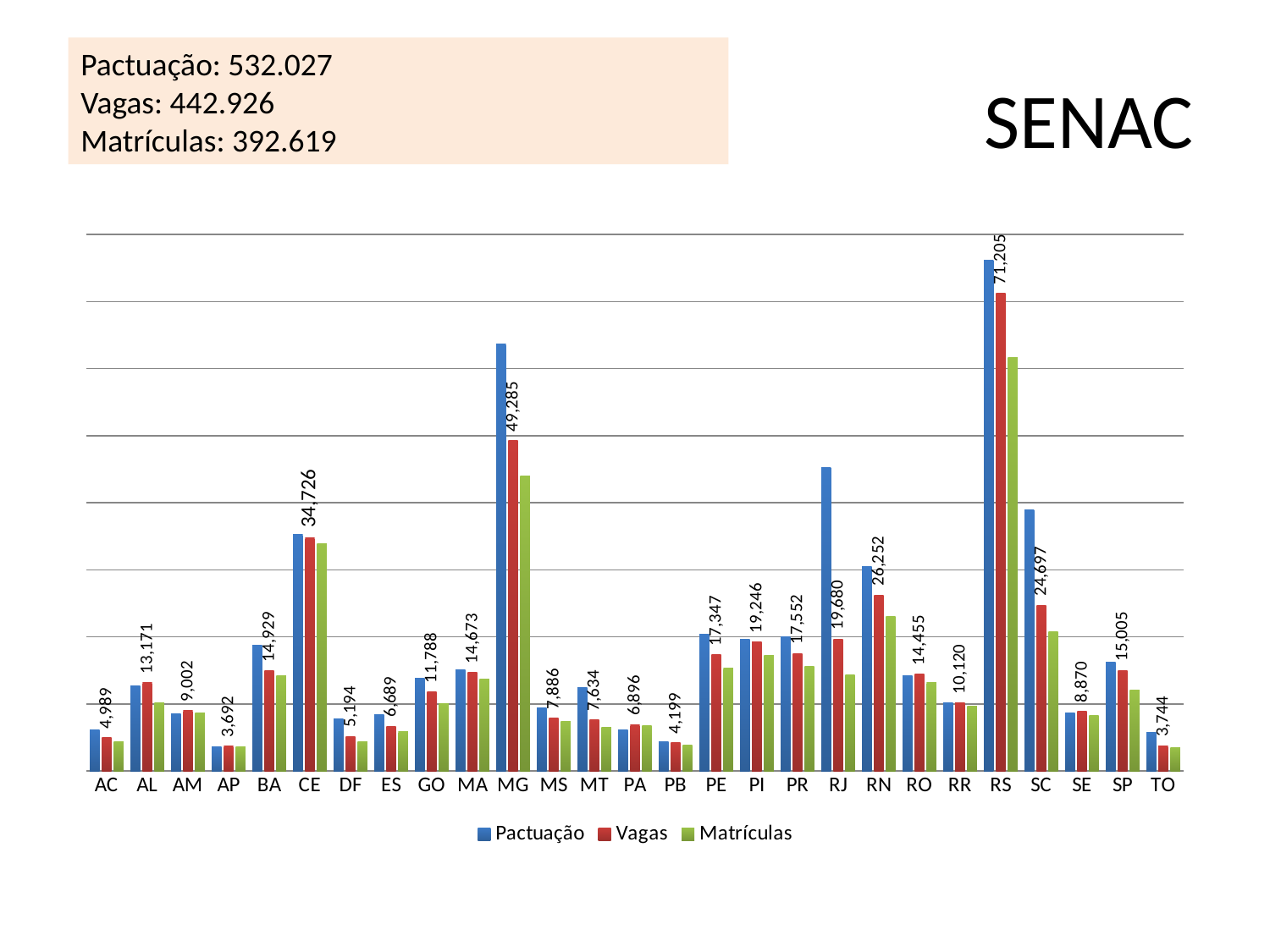
What total for Pactuação is given in the text box at the top of the slide? 532.027 How many series does the legend list? 3 Which state has the larger data label, CE or RN? CE What data label is shown for CE? 34,726 What data label is shown for MG? 49,285 How many state categories are shown along the x axis? 27 Which state has the lowest data label on the chart? AP What data label is shown for RS? 71,205 Which state has the highest data label on the chart? RS What kind of chart is shown on the slide? bar chart What is the difference between the data labels for RS and MG? 21,920 What data label is shown for AP? 3,692